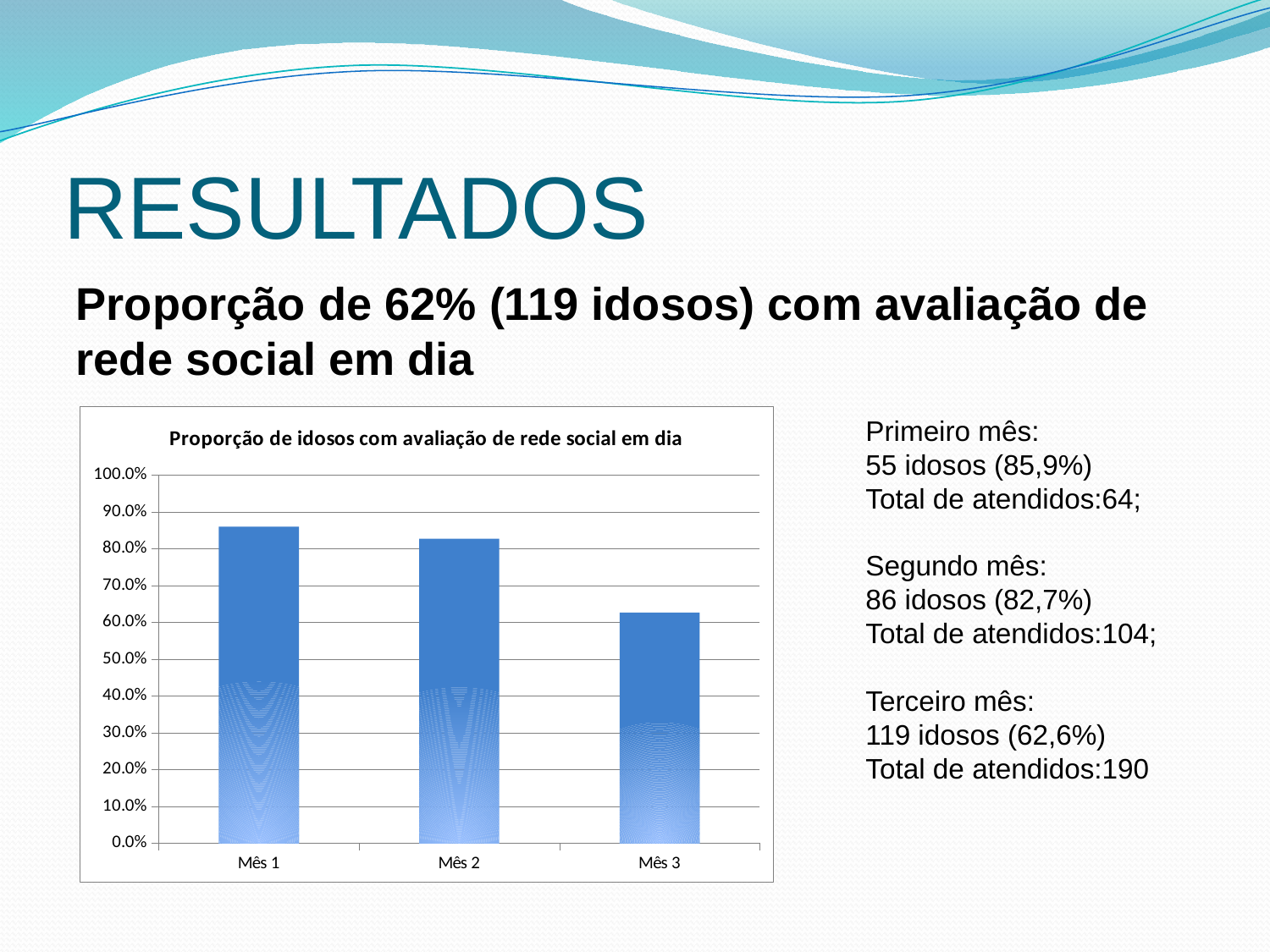
Which month has the highest bar in the chart? Mês 1 Is the value for Mês 3 greater or less than 70.0%? less Do the values rise or fall from Mês 1 to Mês 3? fall Is the value for Mês 1 greater or less than 80.0%? greater Is the value for Mês 2 greater or less than 90.0%? less What is the title of the chart? Proporção de idosos com avaliação de rede social em dia How many categories (months) are shown on the x axis of the chart? 3 Which month has the lowest bar in the chart? Mês 3 What kind of chart is shown on the slide? bar chart Which is larger, the value for Mês 2 or the value for Mês 3? Mês 2 What is the highest tick value shown on the y axis of the chart? 100.0%